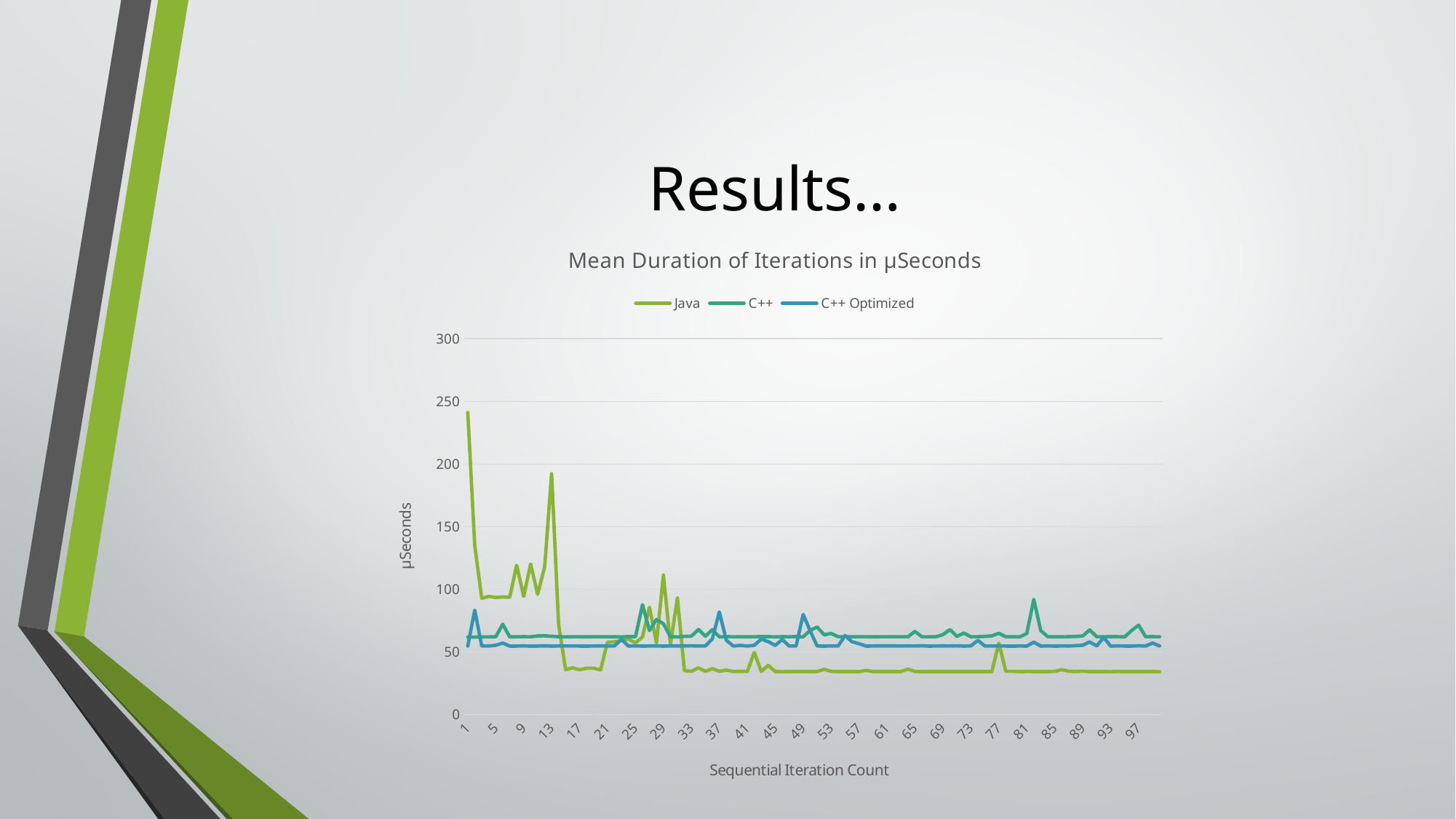
Is the Java value at iteration 13 greater or less than 150? greater Which series has the highest value at iteration 1? Java What kind of chart is shown on the slide? line chart Which series has the lowest value at iteration 97? Java Does the Java series generally rise or fall from iteration 1 to iteration 97? fall Is the Java value at iteration 17 greater or less than 50? less Is the C++ value at iteration 1 greater or less than 100? less What is the title of the chart? Mean Duration of Iterations in µSeconds At iteration 1, is the Java value larger or smaller than the C++ Optimized value? larger How many series does the legend list? 3 What is the label of the x axis? Sequential Iteration Count